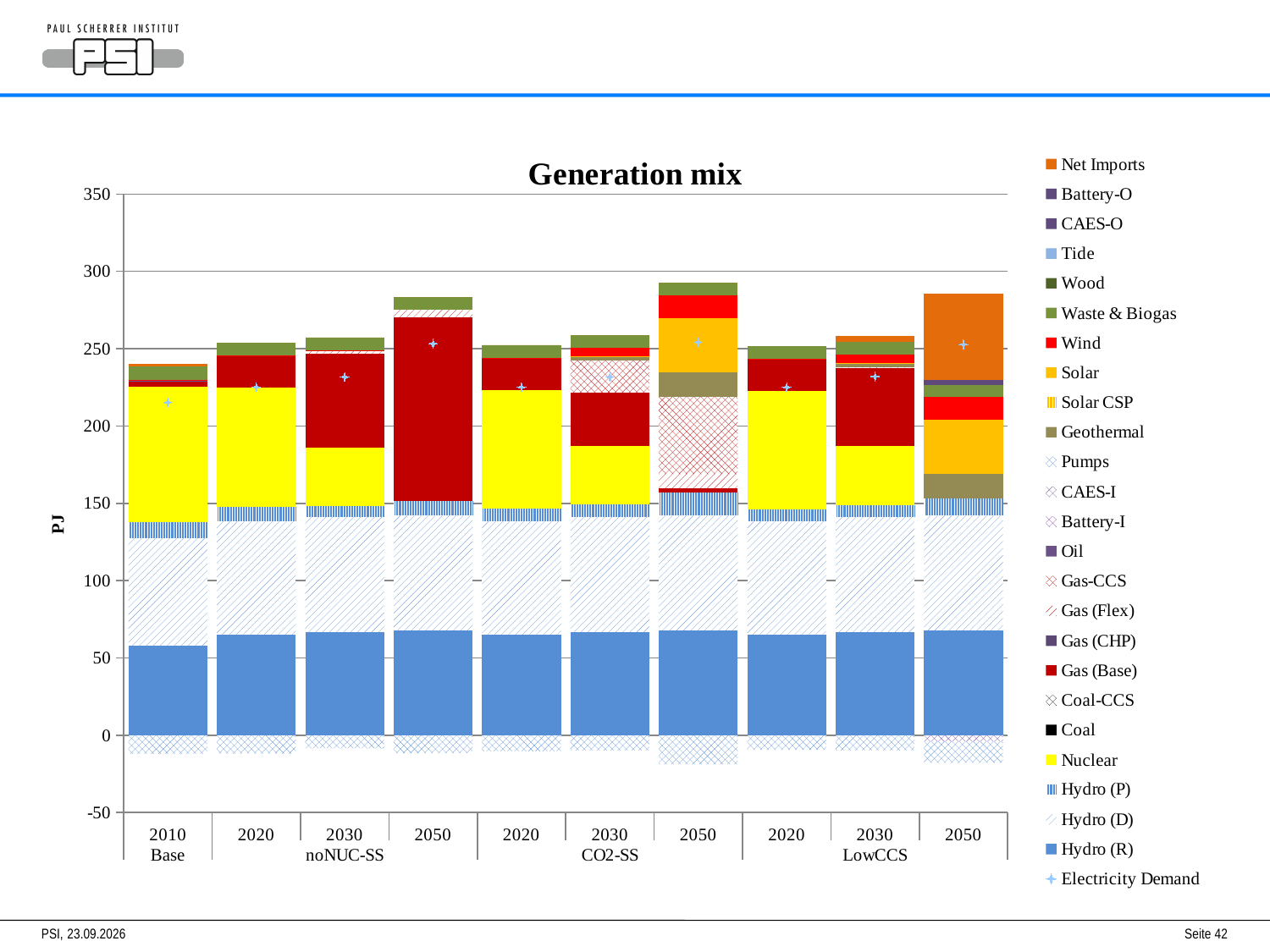
Which bar has the largest Net Imports segment? 2050 LowCCS What kind of chart is shown on the slide? Stacked bar chart Is the total generation for 2050 noNUC-SS greater or less than 250? greater What unit is shown on the y-axis label? PJ Which bar is taller in total: 2050 noNUC-SS or 2010 Base? 2050 noNUC-SS Which bar has the lowest total generation (top of the stacked bar)? 2010 Base Within the noNUC-SS scenario, does total generation rise or fall from 2020 to 2050? rise Is the Hydro (R) value for 2010 Base greater or less than 100? less Is the total generation for 2010 Base greater or less than 250? less What is the title of the chart? Generation mix How many bars (year/scenario combinations) are plotted in the chart? 10 How many entries does the legend list? 25